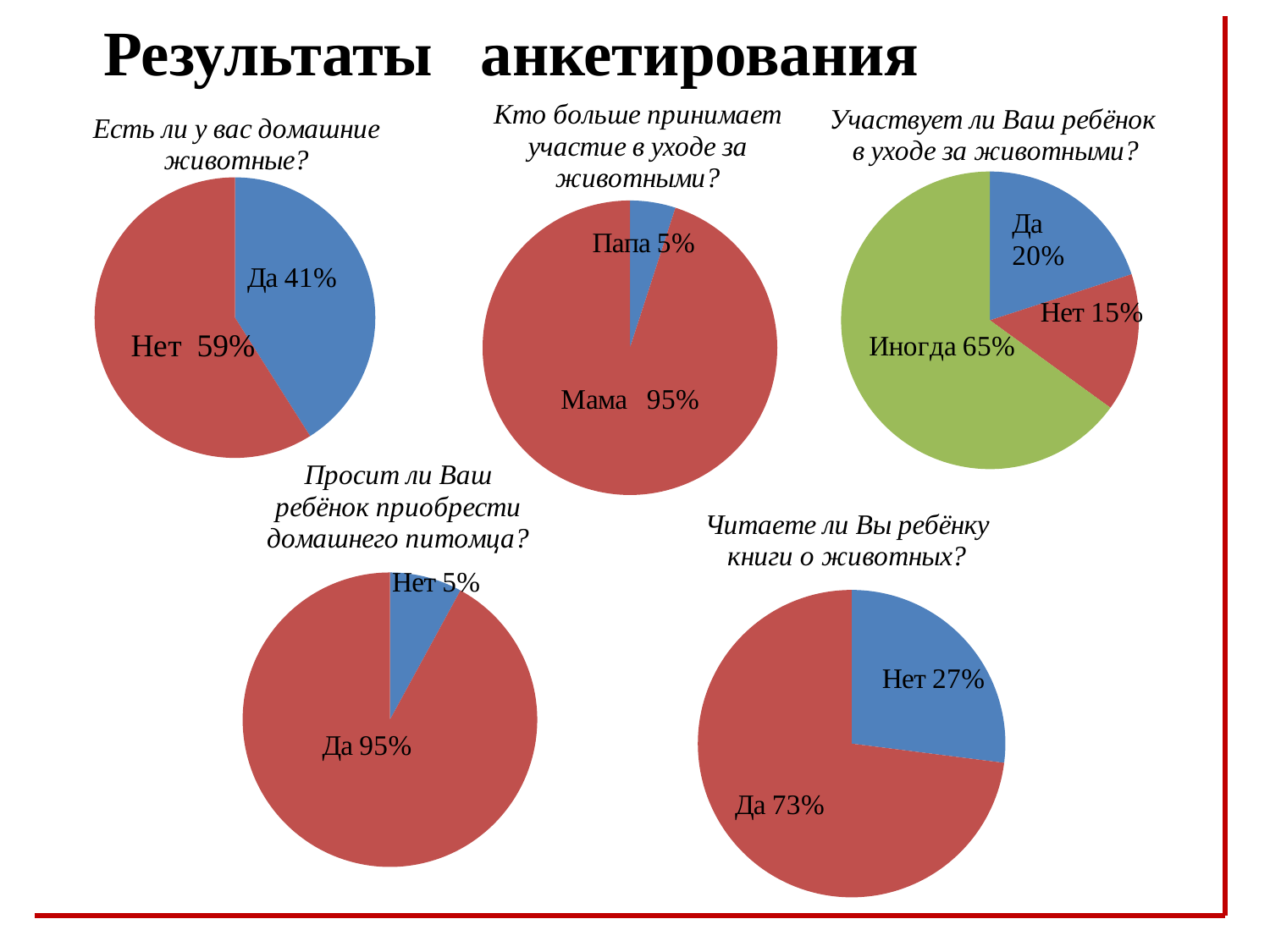
In the chart titled "Кто больше принимает участие в уходе за животными?", what is the difference between the "Мама" and "Папа" shares? 90% In the chart titled "Читаете ли Вы ребёнку книги о животных?", which is larger, "Да" or "Нет"? Да In the chart titled "Есть ли у вас домашние животные?", what share of respondents answered "Да"? 41% In the chart titled "Участвует ли Ваш ребёнок в уходе за животными?", which category has the largest share? Иногда In the chart titled "Участвует ли Ваш ребёнок в уходе за животными?", how many slices does the pie have? 3 In the chart titled "Просит ли Ваш ребёнок приобрести домашнего питомца?", what share answered "Нет"? 5% What type of chart is used for "Есть ли у вас домашние животные?"? Pie chart In the chart titled "Читаете ли Вы ребёнку книги о животных?", what is the difference between the "Да" and "Нет" shares? 46% In the chart titled "Есть ли у вас домашние животные?", what share of respondents answered "Нет"? 59% In the chart titled "Участвует ли Ваш ребёнок в уходе за животными?", which category has the smallest share? Нет How many pie charts are shown on the slide? 5 In the chart titled "Кто больше принимает участие в уходе за животными?", what is the value for "Мама"? 95%